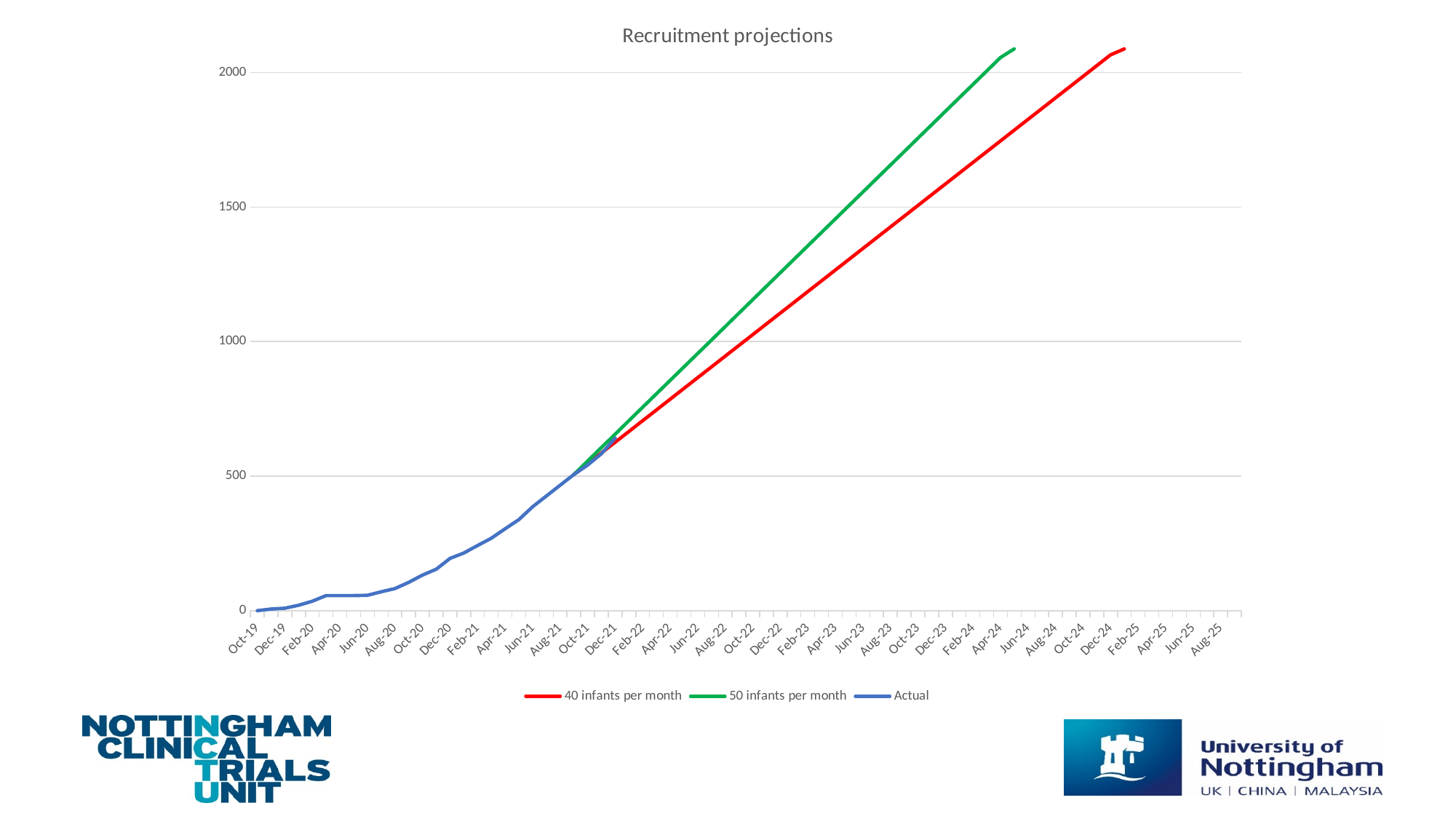
Is the value of the '50 infants per month' series at Dec-23 greater or less than 2000? less Is the value of the 'Actual' series at Dec-21 greater or less than 500? greater How many series does the legend list? 3 Which colour is used for the 'Actual' series? Blue Is the value of the '50 infants per month' series at Oct-22 greater or less than 1000? greater Which projection series reaches 2000 earlier on the x axis? 50 infants per month What is the title of the chart? Recruitment projections At Jun-23, which series has the higher value: '40 infants per month' or '50 infants per month'? 50 infants per month Does the 'Actual' series rise or fall from Oct-19 to Dec-21? Rise What type of chart is shown on the slide? Line chart